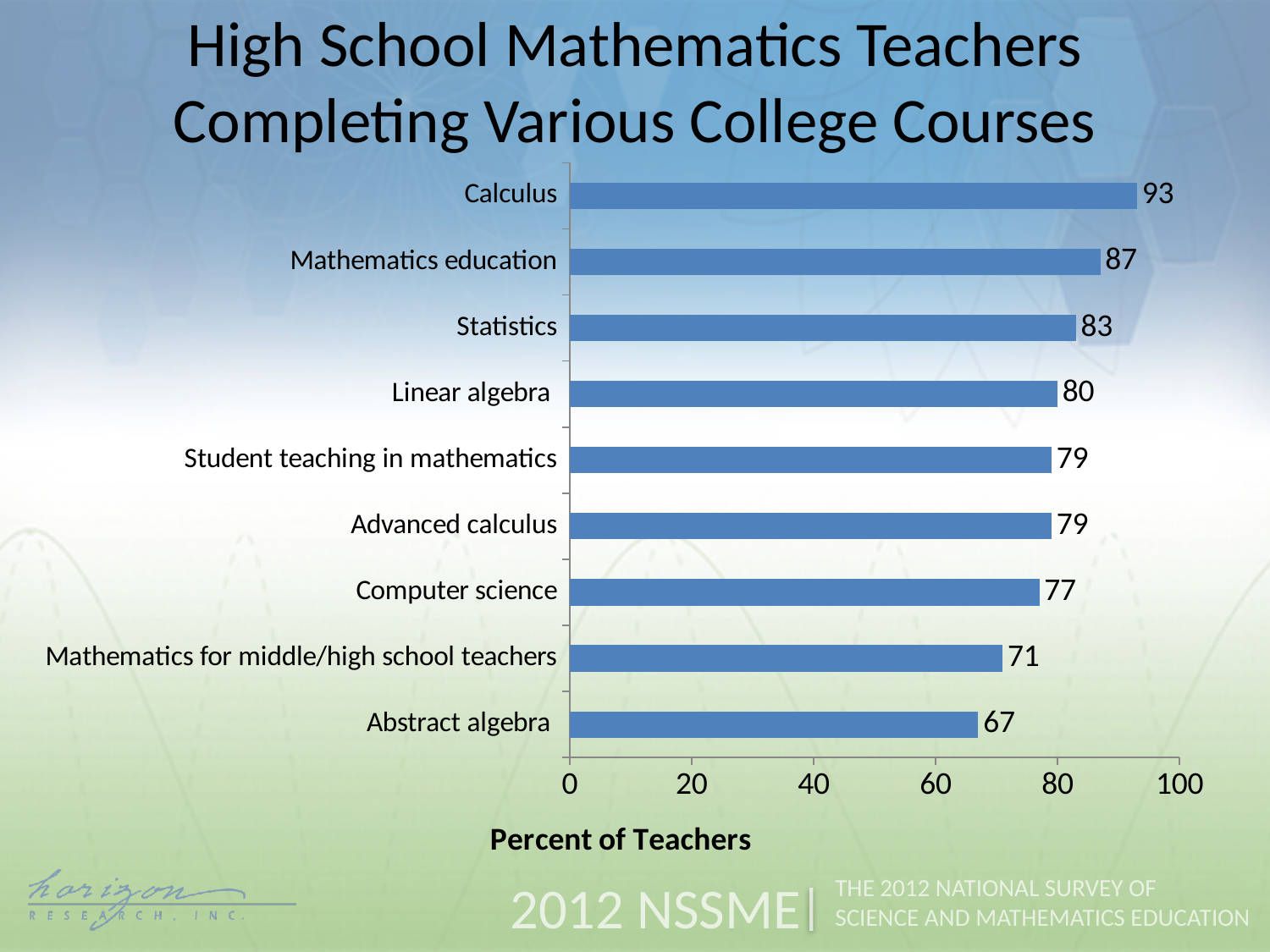
What percent of high school mathematics teachers completed Calculus? 93 What is the difference between the values for Calculus and Abstract algebra? 26 What is the label of the horizontal axis? Percent of Teachers Which course has the lowest percent of teachers? Abstract algebra What kind of chart is shown on the slide? bar chart Is the value for Statistics greater or less than 80? greater What is the value for Mathematics for middle/high school teachers? 71 Which course has the highest percent of teachers? Calculus What is the difference between the values for Mathematics education and Statistics? 4 How many courses are shown in the chart? 9 What is the value for Abstract algebra? 67 Which is larger, the value for Linear algebra or the value for Computer science? Linear algebra